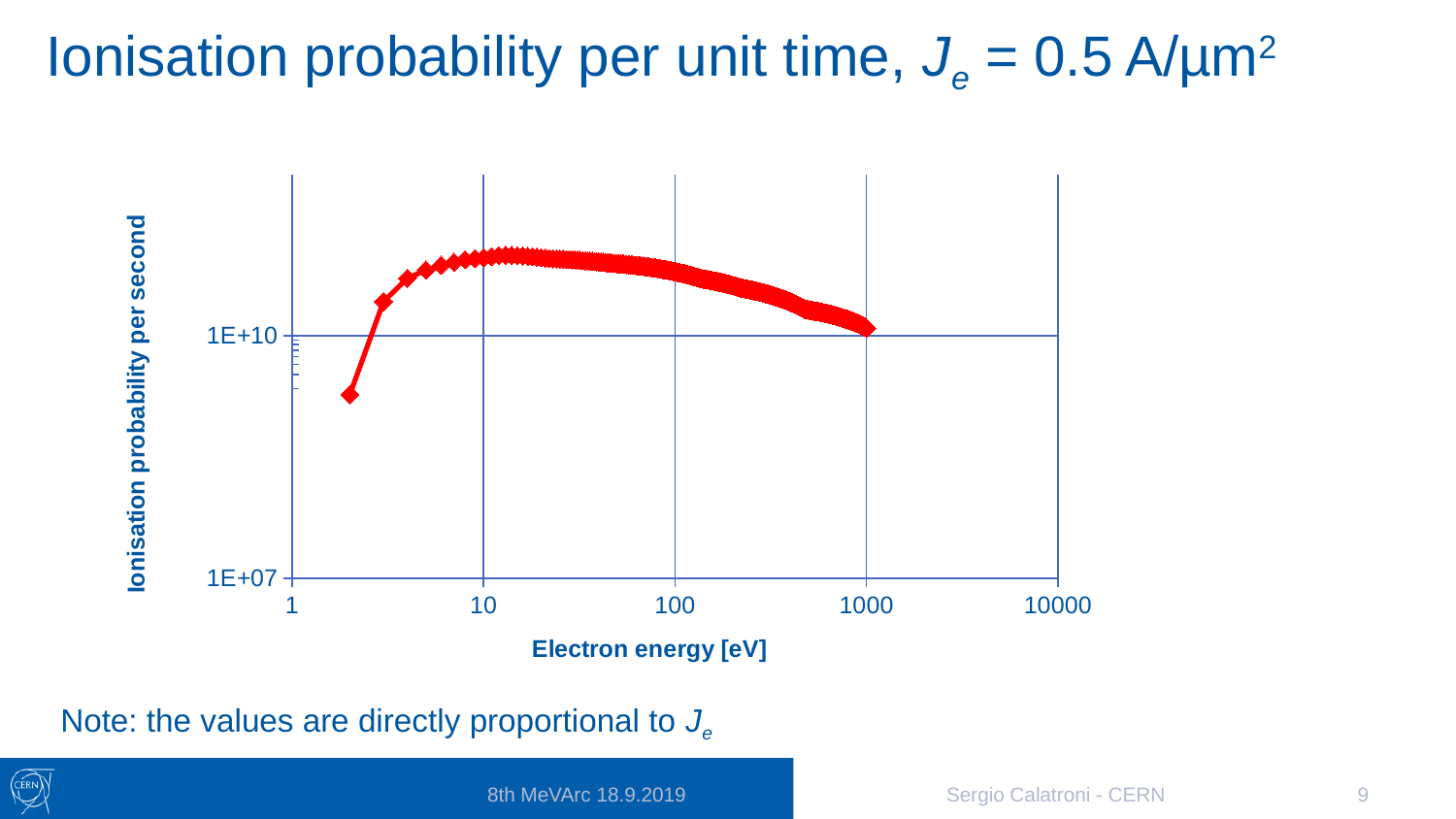
Which has the higher ionisation probability per second: the point at 10 eV or the point at 1000 eV? the point at 10 eV Is the ionisation probability per second at an electron energy of 100 eV greater or less than 1E+07? greater What is the title of the x axis of the chart? Electron energy [eV] Is the ionisation probability per second at an electron energy of 100 eV greater or less than 1E+10? greater How does the ionisation probability per second change as electron energy increases from 100 eV to 1000 eV? it falls Is the ionisation probability per second at the lowest plotted electron energy (about 2 eV) greater or less than 1E+10? less What is the title of the y axis of the chart? Ionisation probability per second How does the ionisation probability per second change as electron energy increases from about 2 eV to 10 eV? it rises What is the largest electron energy value labelled on the x axis? 10000 Which has the higher ionisation probability per second: the point at about 2 eV or the point at 10 eV? the point at 10 eV What kind of chart is shown on the slide? scatter chart